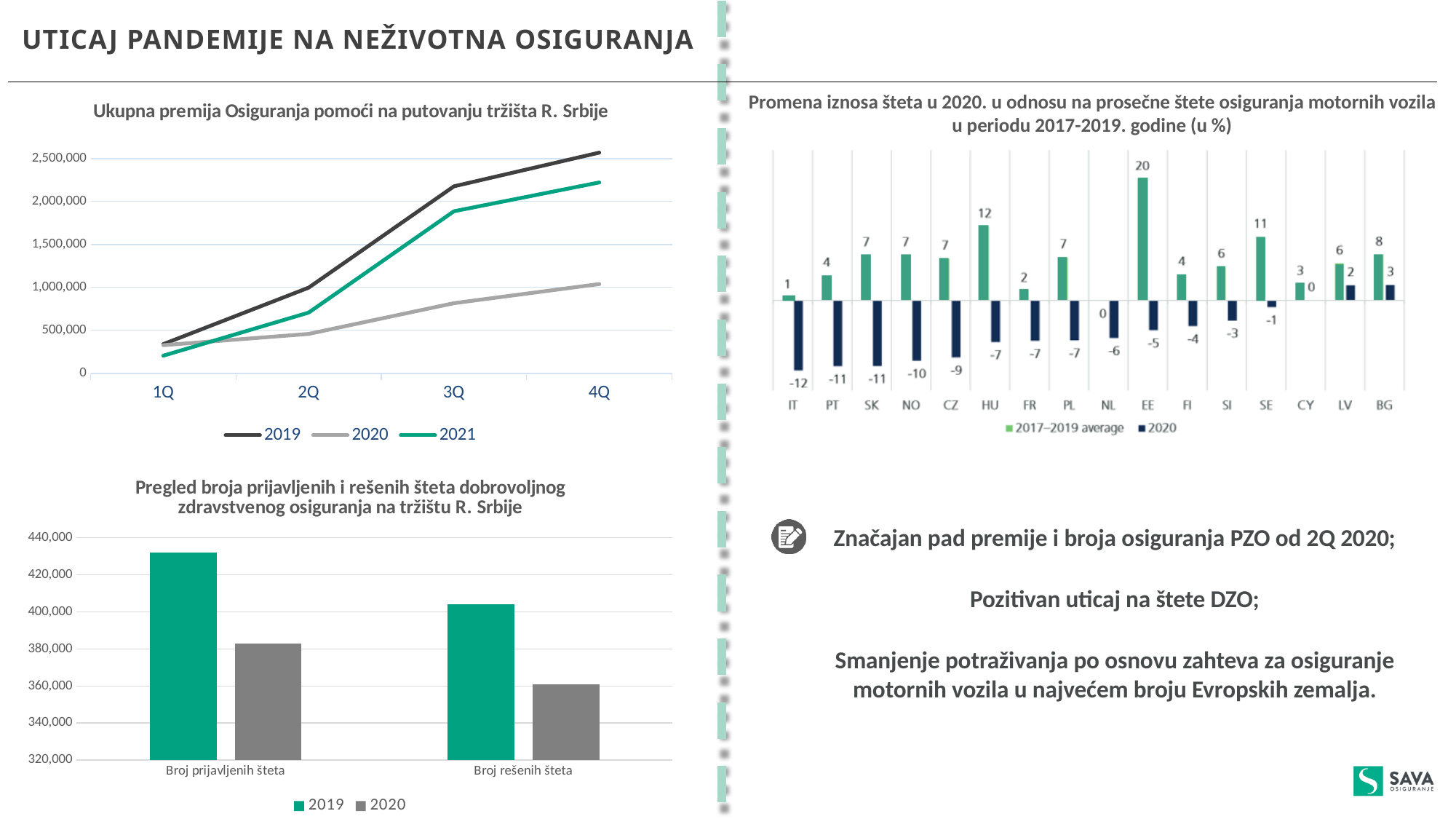
In the chart 'Ukupna premija Osiguranja pomoći na putovanju tržišta R. Srbije', is the value for 2021 at 1Q greater or less than 500,000? less In the chart 'Pregled broja prijavljenih i rešenih šteta dobrovoljnog zdravstvenog osiguranja na tržištu R. Srbije', which is larger for 'Broj prijavljenih šteta': 2019 or 2020? 2019 In the chart 'Ukupna premija Osiguranja pomoći na putovanju tržišta R. Srbije', do the values for 2019 rise or fall from 1Q to 4Q? rise What kind of chart is 'Ukupna premija Osiguranja pomoći na putovanju tržišta R. Srbije'? line chart In the chart 'Ukupna premija Osiguranja pomoći na putovanju tržišta R. Srbije', how many series does the legend list? 3 In the chart 'Promena iznosa šteta u 2020. u odnosu na prosečne štete osiguranja motornih vozila u periodu 2017-2019. godine (u %)', how many countries are shown on the x axis? 16 In the chart 'Promena iznosa šteta u 2020. u odnosu na prosečne štete osiguranja motornih vozila u periodu 2017-2019. godine (u %)', what is the difference between the 2017–2019 average and the 2020 value for HU? 19 In the chart 'Promena iznosa šteta u 2020. u odnosu na prosečne štete osiguranja motornih vozila u periodu 2017-2019. godine (u %)', what is the 2017–2019 average value for EE? 20 In the chart 'Promena iznosa šteta u 2020. u odnosu na prosečne štete osiguranja motornih vozila u periodu 2017-2019. godine (u %)', which country has the lowest 2020 value? IT In the chart 'Pregled broja prijavljenih i rešenih šteta dobrovoljnog zdravstvenog osiguranja na tržištu R. Srbije', is the 2019 value for 'Broj prijavljenih šteta' greater or less than 420,000? greater In the chart 'Promena iznosa šteta u 2020. u odnosu na prosečne štete osiguranja motornih vozila u periodu 2017-2019. godine (u %)', which country has the highest 2017–2019 average value? EE In the chart 'Promena iznosa šteta u 2020. u odnosu na prosečne štete osiguranja motornih vozila u periodu 2017-2019. godine (u %)', what is the 2020 value for IT? -12